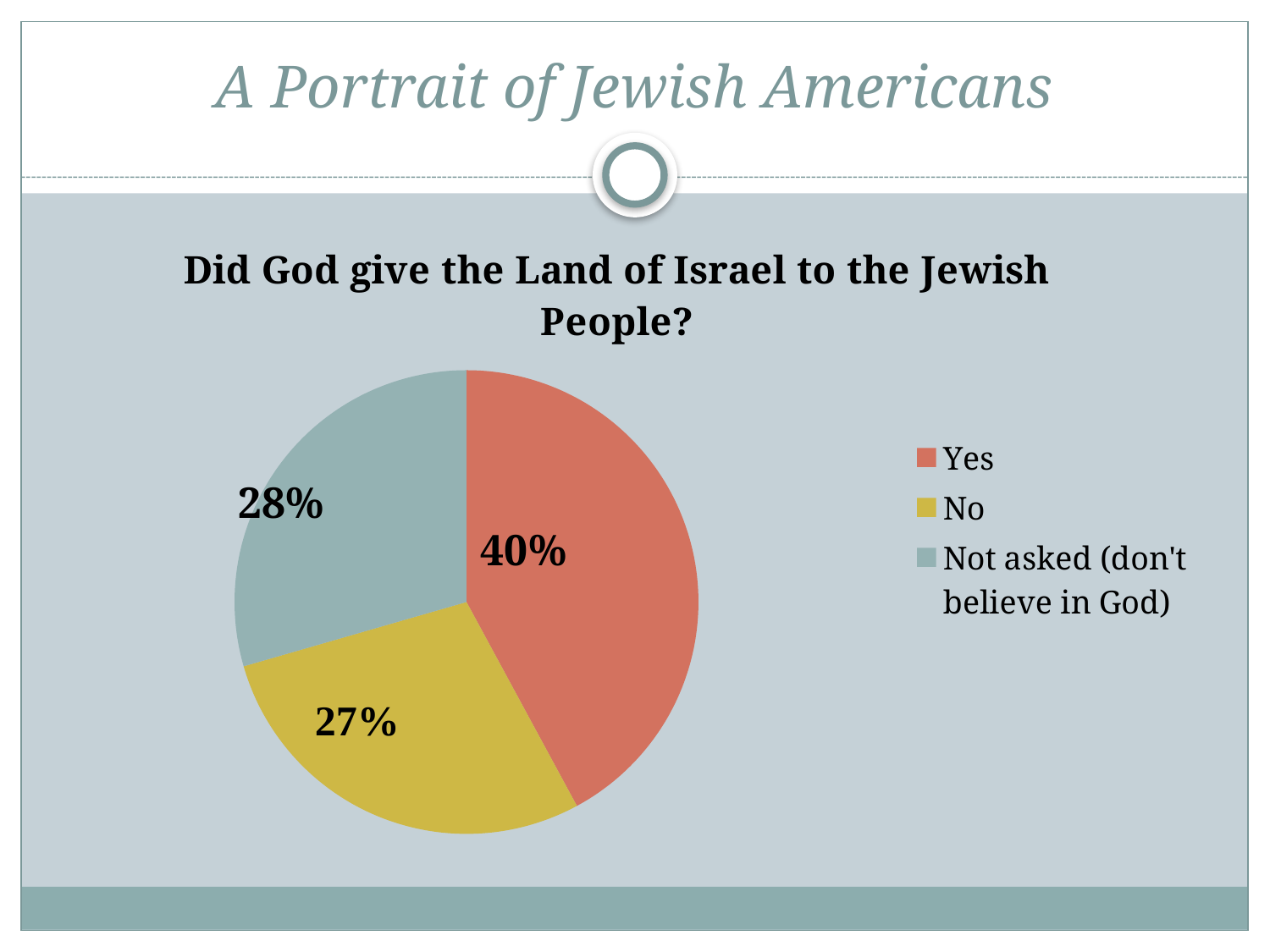
What colour is the "No" slice in the pie chart? yellow What percentage of respondents answered "Yes"? 40% How many slices does the pie chart have? 3 What kind of chart is shown on the slide? pie chart What percentage of respondents answered "No"? 27% Which response has the smallest share of the pie? No What is the difference in percentage points between "Not asked (don't believe in God)" and "No"? 1 Which response has the largest share of the pie? Yes Which is larger, the share for "Yes" or the share for "Not asked (don't believe in God)"? Yes What is the difference in percentage points between "Yes" and "No"? 13 What percentage is shown for "Not asked (don't believe in God)"? 28% What is the title of the chart? Did God give the Land of Israel to the Jewish People?